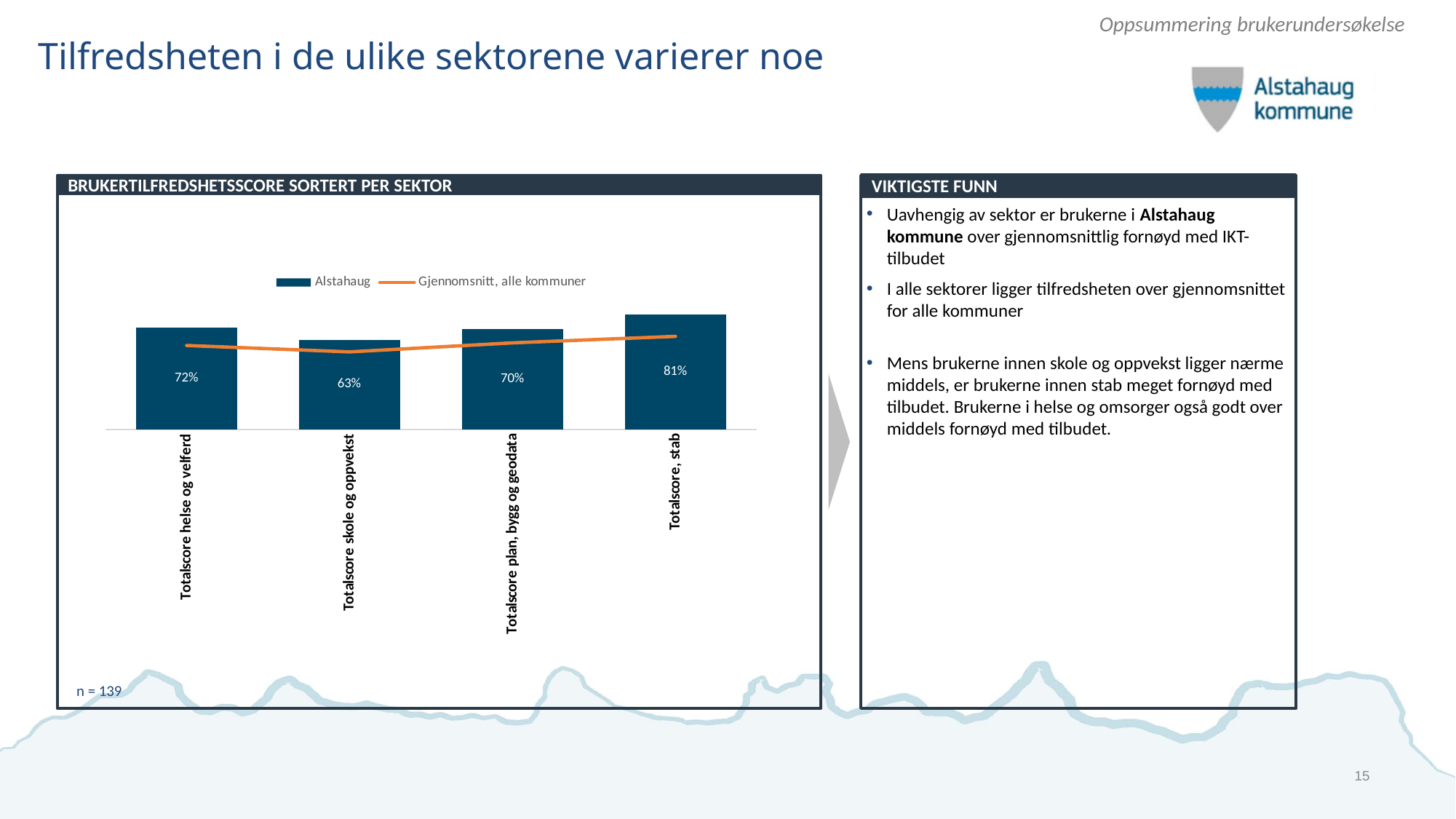
What is the Alstahaug value for Totalscore helse og velferd? 72% What is the difference between the Alstahaug scores for Totalscore, stab and Totalscore skole og oppvekst? 18 percentage points What is the Alstahaug value for Totalscore skole og oppvekst? 63% Which category has the highest Alstahaug score? Totalscore, stab Which category has the lowest Alstahaug score? Totalscore skole og oppvekst What is the Alstahaug value for Totalscore, stab? 81% What is the title of the chart? BRUKERTILFREDSHETSSCORE SORTERT PER SEKTOR What kind of chart is used to show the Alstahaug scores? Bar chart Which is larger, the Alstahaug score for Totalscore helse og velferd or for Totalscore plan, bygg og geodata? Totalscore helse og velferd What is the Alstahaug value for Totalscore plan, bygg og geodata? 70% How many categories are shown on the x axis of the chart? 4 How many series does the chart legend list? 2